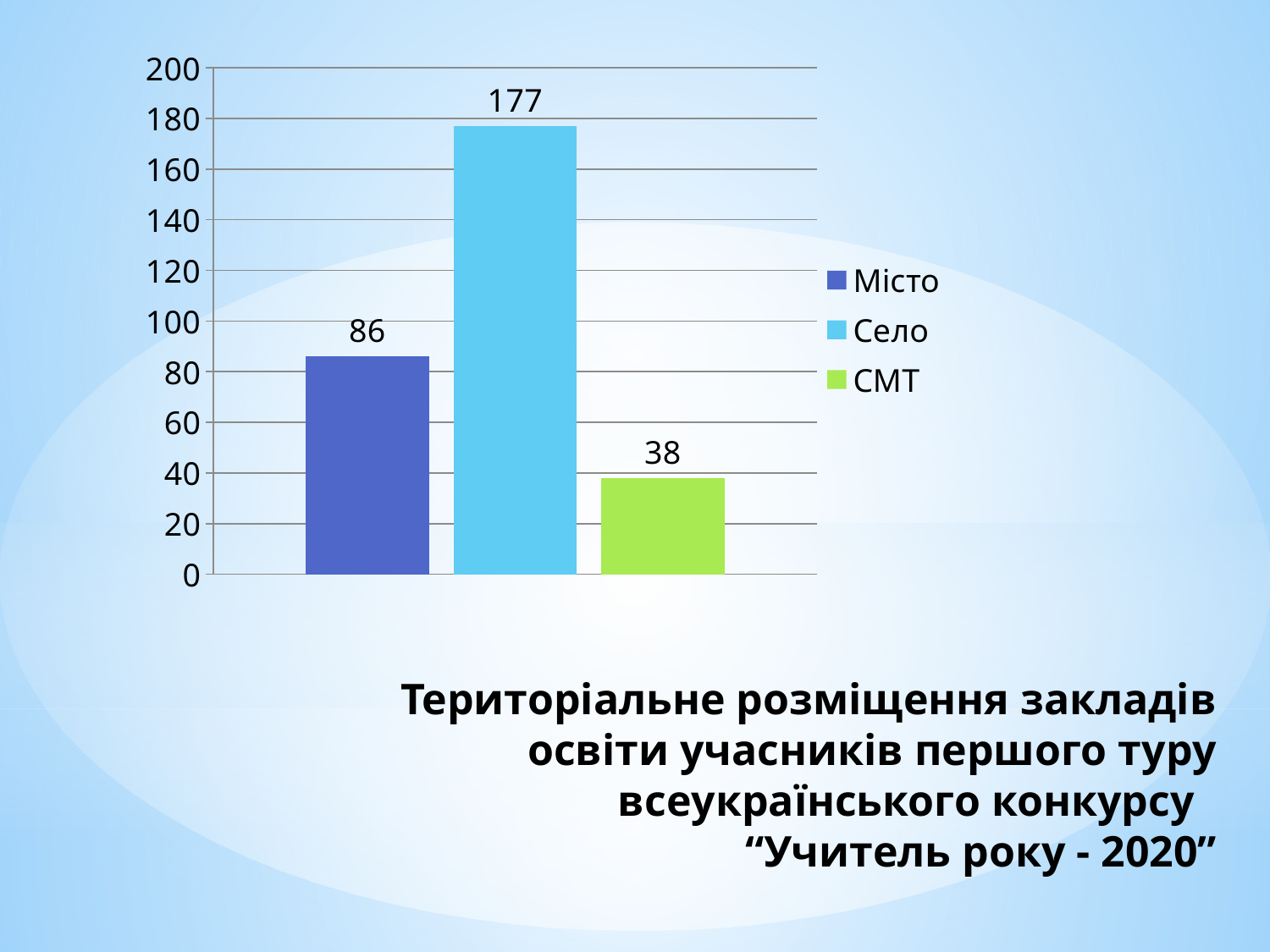
What is the difference between the values for Місто and СМТ? 48 Which category has the highest value? Село What is the value for СМТ? 38 What is the difference between the values for Село and Місто? 91 Which category has the lowest value? СМТ What is the value for Село? 177 Which is larger, the value for Місто or the value for СМТ? Місто What colour is the bar for Село? light blue How many series does the legend list? 3 What kind of chart is shown on the slide? bar chart What is the value for Місто? 86 Is the value for Село greater or less than 160? greater